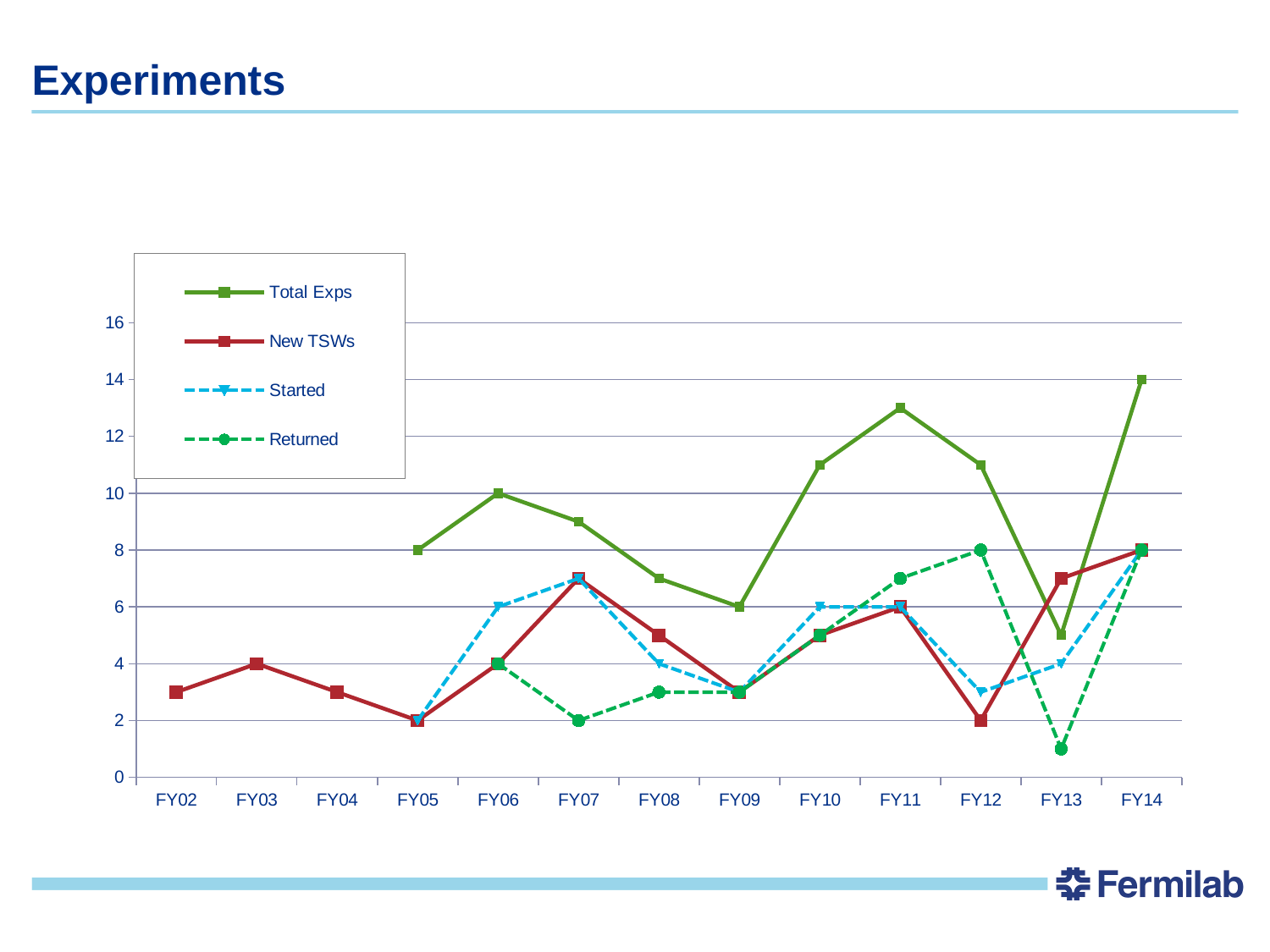
What is the value of Returned in FY12? 8 How many series does the legend list? 4 Does Total Exps rise or fall from FY06 to FY09? fall In which fiscal year is Returned lowest? FY13 What is the difference between Total Exps and New TSWs in FY14? 6 What is the value of New TSWs in FY12? 2 What is the value of Total Exps in FY06? 10 In which fiscal year is Total Exps highest? FY14 What is the value of Total Exps in FY14? 14 Is the value for Total Exps in FY11 greater or less than 12? greater What kind of chart is shown on the slide? line chart How many fiscal years are shown on the x axis? 13